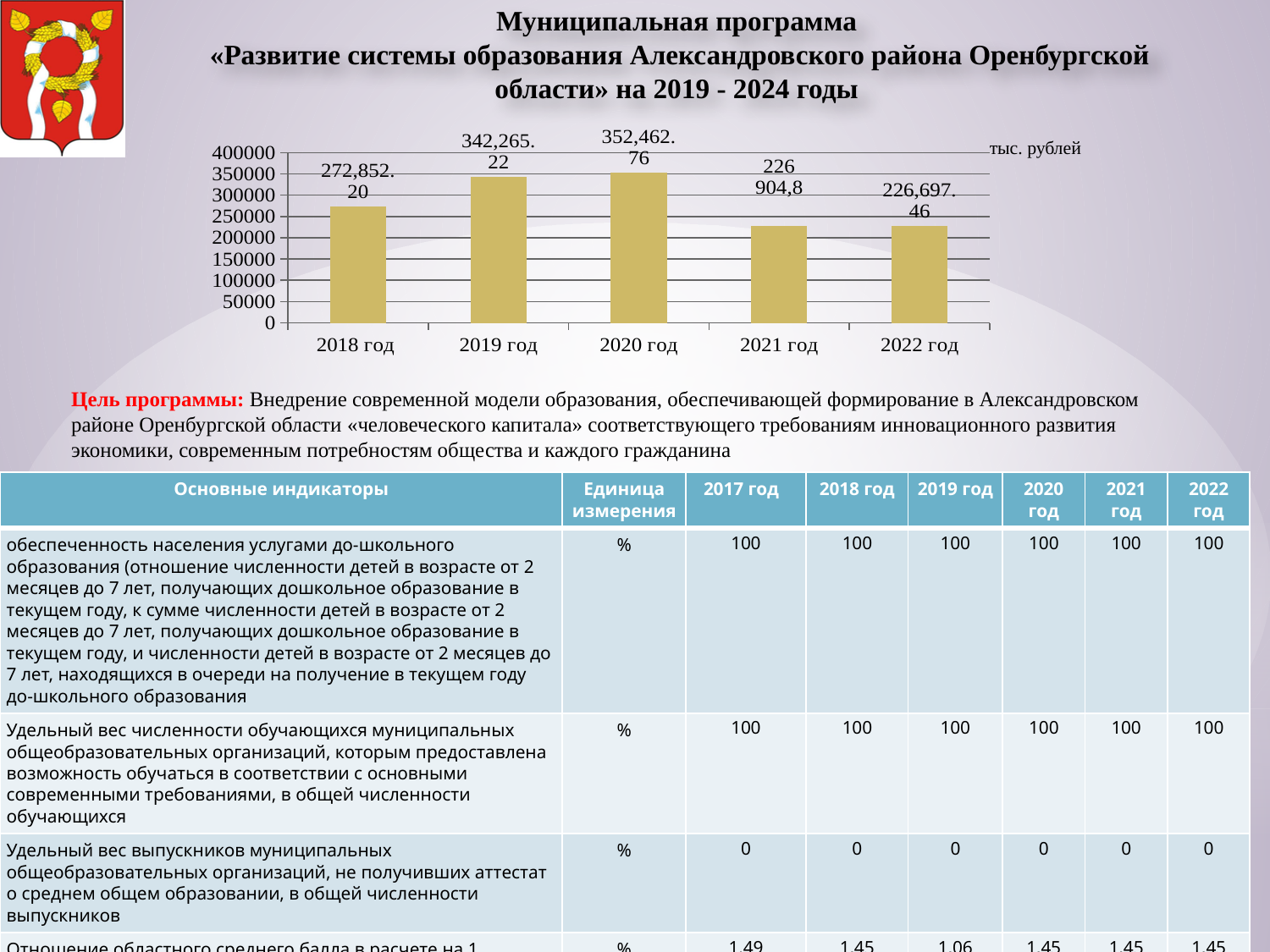
What is the difference between the values for 2020 год and 2019 год? 10,197.54 Is the value for 2021 год greater or less than 250000? less What unit of measurement is written next to the chart? тыс. рублей Which year has the highest value on the chart? 2020 год What is the value shown for 2022 год? 226,697.46 What type of chart is shown on the slide? bar chart What is the value shown for 2019 год? 342,265.22 What is the value shown for 2018 год? 272,852.20 What is the value shown for 2020 год? 352,462.76 How many years (categories) are plotted on the chart? 5 Which is larger, the value for 2018 год or for 2019 год? 2019 год Do the values rise or fall from 2020 год to 2022 год? fall